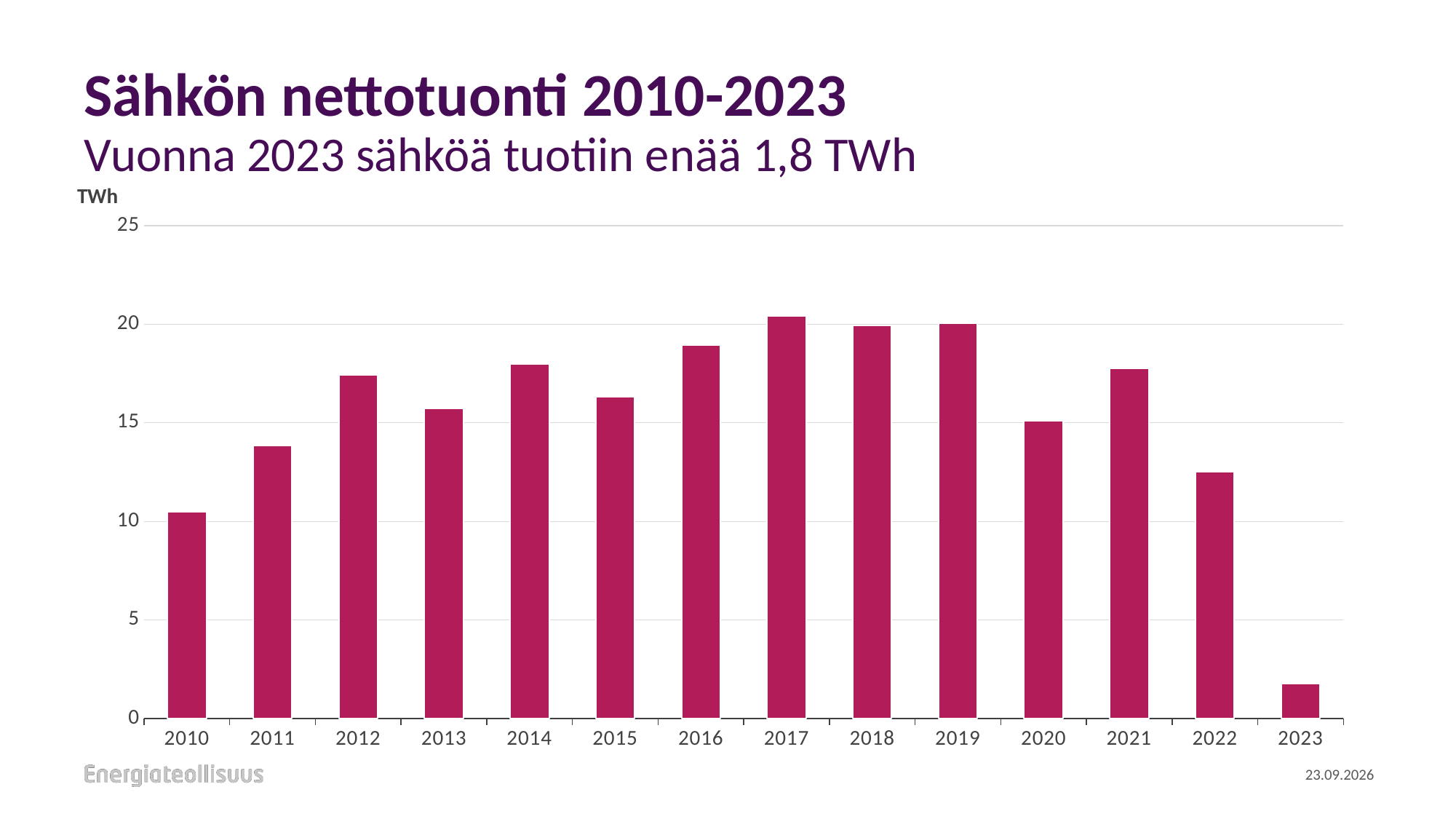
Is the value for 2010 greater or less than 15? less What unit is shown on the vertical axis? TWh Is the value for 2022 greater or less than 10? greater Is the value for 2016 greater or less than 20? less Do the values rise or fall from 2019 to 2023? fall What is the title of the chart? Sähkön nettotuonti 2010-2023 Which year has the lowest value in the chart? 2023 What kind of chart is shown on the slide? bar chart What was the net import of electricity in 2023 according to the slide? 1,8 TWh How many years (bars) are plotted in the chart? 14 Which is larger, the value for 2012 or the value for 2013? 2012